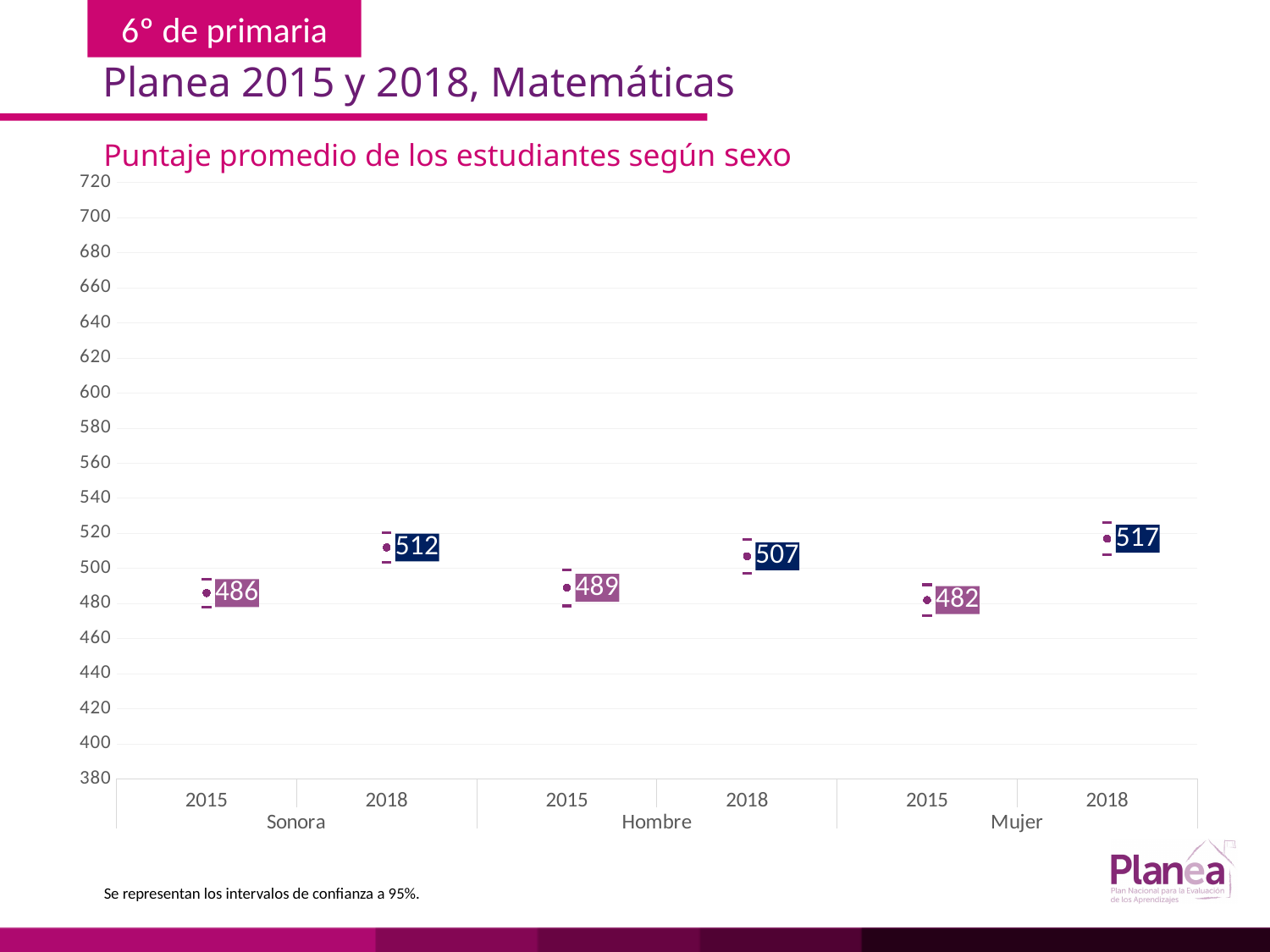
How many data points are plotted on the chart? 6 What is the average score for Mujer in 2015? 482 What is the average score for Sonora in 2015? 486 What is the average score for Sonora in 2018? 512 What is the difference between the Mujer scores in 2018 and 2015? 35 What is the average score for Hombre in 2018? 507 What is the title of the chart? Puntaje promedio de los estudiantes según sexo Which group and year has the lowest average score? Mujer 2015 Which group and year has the highest average score? Mujer 2018 What is the average score for Hombre in 2015? 489 Which is larger in 2018, the Hombre score or the Mujer score? Mujer By how many points did the Sonora average score change from 2015 to 2018? 26